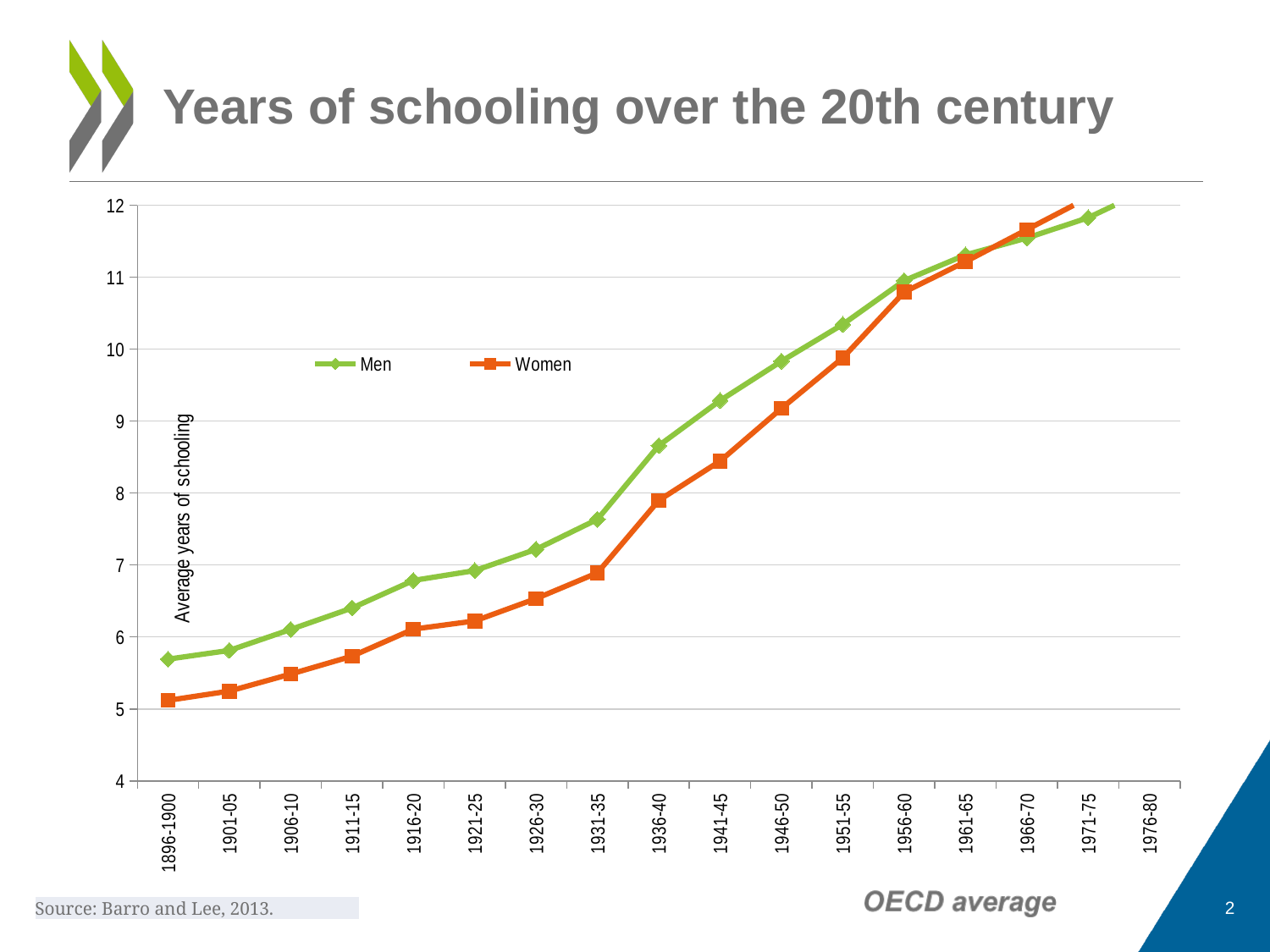
Is the value for Men in 1896-1900 greater or less than 6? less In 1896-1900, which series has the higher value, Men or Women? Men Is the value for Women in 1951-55 greater or less than 10? less Is the value for Women in 1941-45 greater or less than 8? greater What is the label on the vertical axis? Average years of schooling Do the values for Women rise or fall across the periods shown? rise How many series does the legend list? 2 How many period labels are shown along the x axis? 17 In 1936-40, which series has the higher value, Men or Women? Men What kind of chart is shown on the slide? line chart Which two series are shown in the legend? Men and Women Do the values for Men rise or fall from 1896-1900 to 1971-75? rise